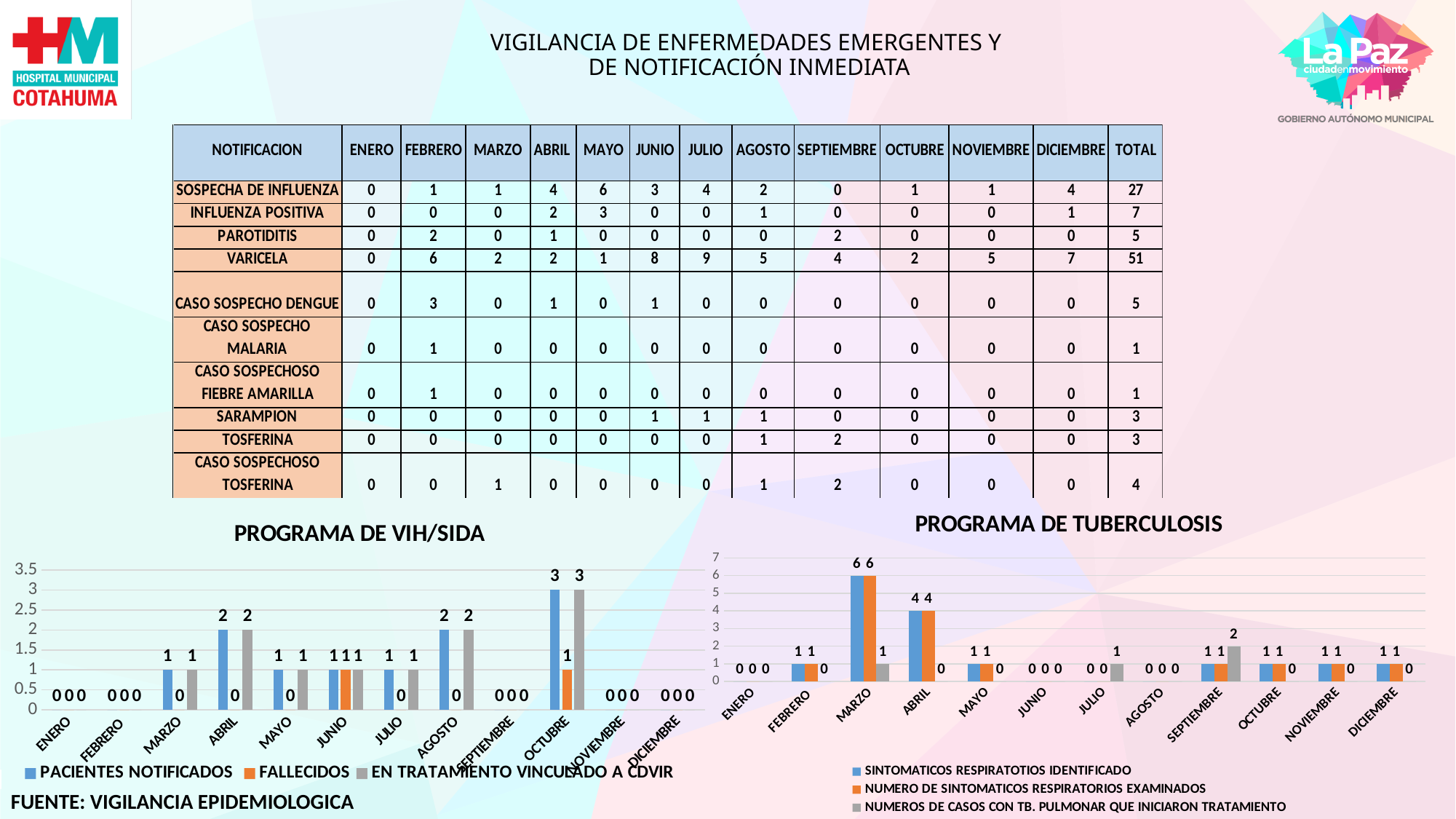
In the PROGRAMA DE TUBERCULOSIS chart, is the value of SINTOMATICOS RESPIRATOTIOS IDENTIFICADO for MARZO or for ABRIL larger? MARZO In the PROGRAMA DE VIH/SIDA chart, how many series does the legend list? 3 In the PROGRAMA DE VIH/SIDA chart, which month has the highest value for PACIENTES NOTIFICADOS? OCTUBRE In the PROGRAMA DE TUBERCULOSIS chart, what is the difference between SINTOMATICOS RESPIRATOTIOS IDENTIFICADO in MARZO and in ABRIL? 2 In the PROGRAMA DE VIH/SIDA chart, what is the difference between PACIENTES NOTIFICADOS and FALLECIDOS in OCTUBRE? 2 What type of chart is the PROGRAMA DE TUBERCULOSIS chart? Bar chart In the PROGRAMA DE VIH/SIDA chart, what is the value of PACIENTES NOTIFICADOS for OCTUBRE? 3 In the PROGRAMA DE VIH/SIDA chart, what is the value of FALLECIDOS for JUNIO? 1 In the PROGRAMA DE TUBERCULOSIS chart, what is the value of NUMEROS DE CASOS CON TB. PULMONAR QUE INICIARON TRATAMIENTO for SEPTIEMBRE? 2 In the PROGRAMA DE VIH/SIDA chart, how many months are shown on the x axis? 12 In the PROGRAMA DE TUBERCULOSIS chart, which month has the highest value for NUMERO DE SINTOMATICOS RESPIRATORIOS EXAMINADOS? MARZO In the PROGRAMA DE TUBERCULOSIS chart, what is the value of SINTOMATICOS RESPIRATOTIOS IDENTIFICADO for MARZO? 6